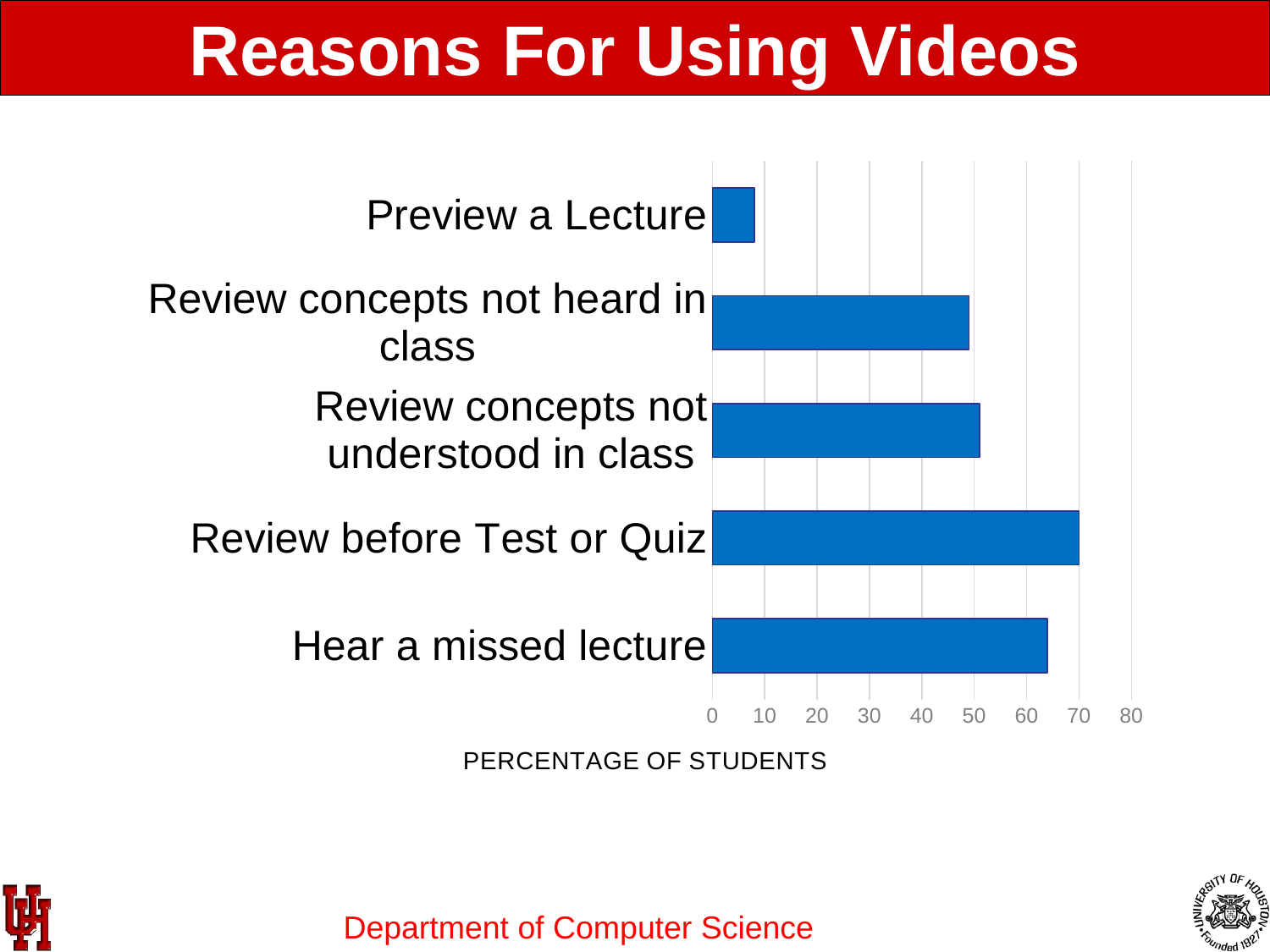
What is the title of the slide containing the chart? Reasons For Using Videos Which reason has the highest percentage of students? Review before Test or Quiz Which has a larger value: Preview a Lecture or Review concepts not heard in class? Review concepts not heard in class Which has a larger value: Review before Test or Quiz or Hear a missed lecture? Review before Test or Quiz Is the value for Review concepts not understood in class greater or less than 40? greater Is the value for Review before Test or Quiz greater or less than 60? greater What kind of chart is shown on the slide? bar chart Which reason has the lowest percentage of students? Preview a Lecture What is the label of the horizontal axis? PERCENTAGE OF STUDENTS Is the value for Hear a missed lecture greater or less than 60? greater How many reasons (categories) are plotted in the chart? 5